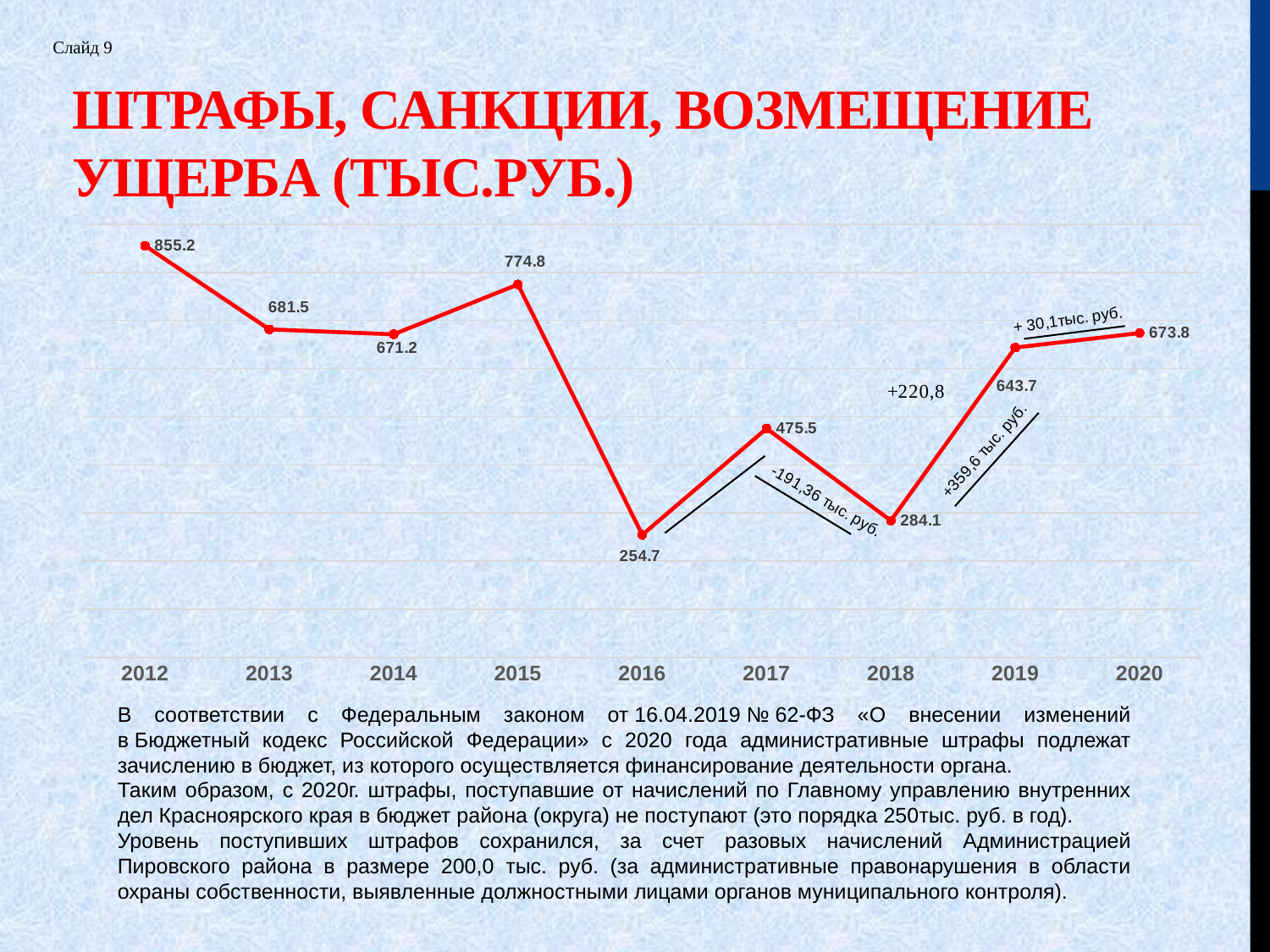
What is the value for 2016? 254.7 What is the value for 2020? 673.8 What is the value for 2012? 855.2 Which year has the highest value? 2012 What kind of chart is shown on the slide? line chart Do the values rise or fall from 2018 to 2020? rise What is the difference between the values for 2019 and 2018? 359.6 What is the difference between the values for 2020 and 2019? 30.1 How many years are plotted on the chart? 9 What is the value for 2019? 643.7 Which is larger, the value for 2017 or the value for 2018? 2017 Which year has the lowest value? 2016